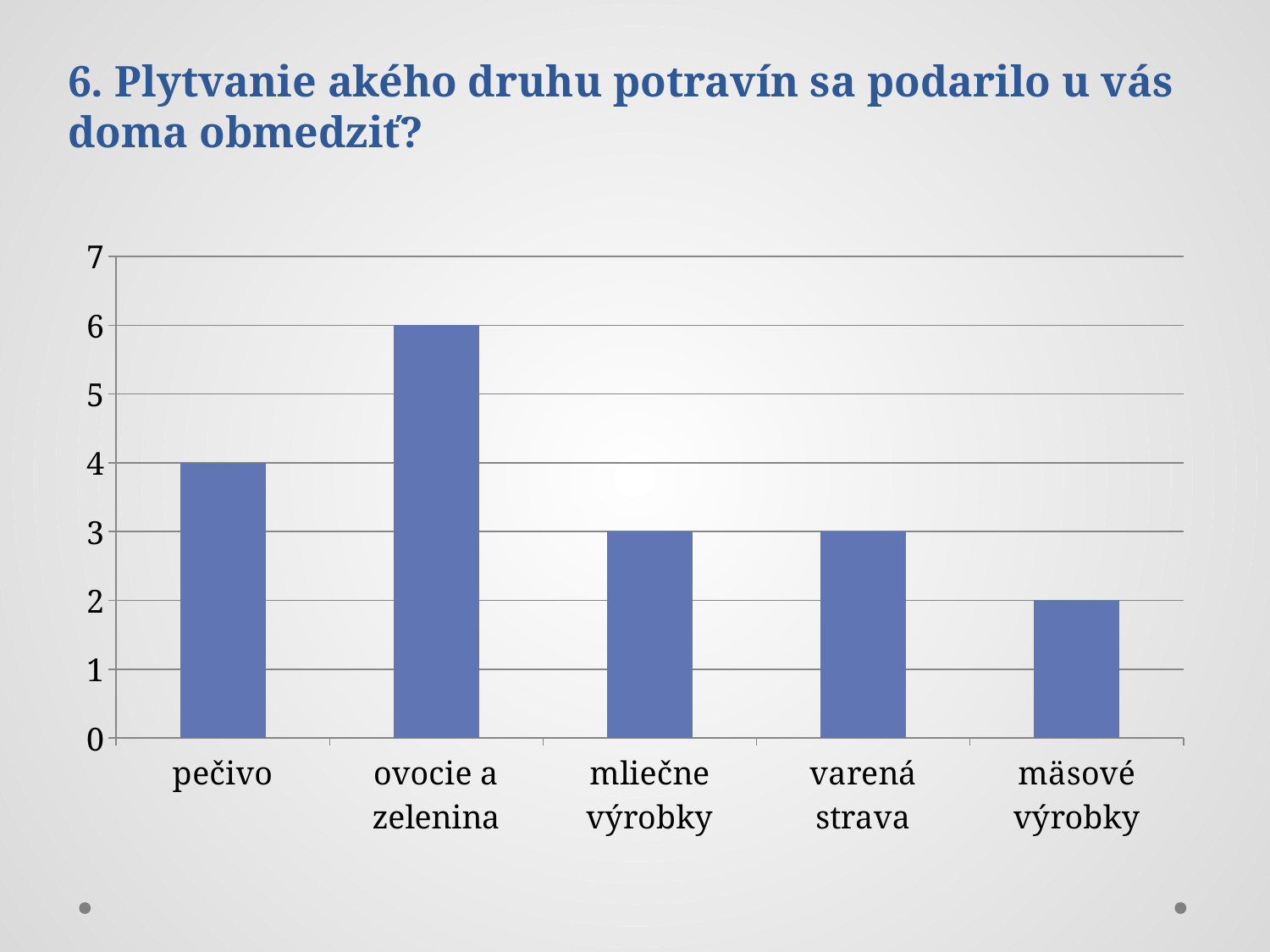
What is the value for ovocie a zelenina? 6 Is the value for ovocie a zelenina greater or less than 5? greater Which category has the highest value? ovocie a zelenina What is the difference between the values for ovocie a zelenina and pečivo? 2 What is the value for mliečne výrobky? 3 What is the value for mäsové výrobky? 2 What is the value for pečivo? 4 What kind of chart is shown on the slide? bar chart Which category has the lowest value? mäsové výrobky What is the title of the slide containing the chart? 6. Plytvanie akého druhu potravín sa podarilo u vás doma obmedziť? How many categories are shown on the x axis? 5 Which is larger, the value for pečivo or the value for varená strava? pečivo